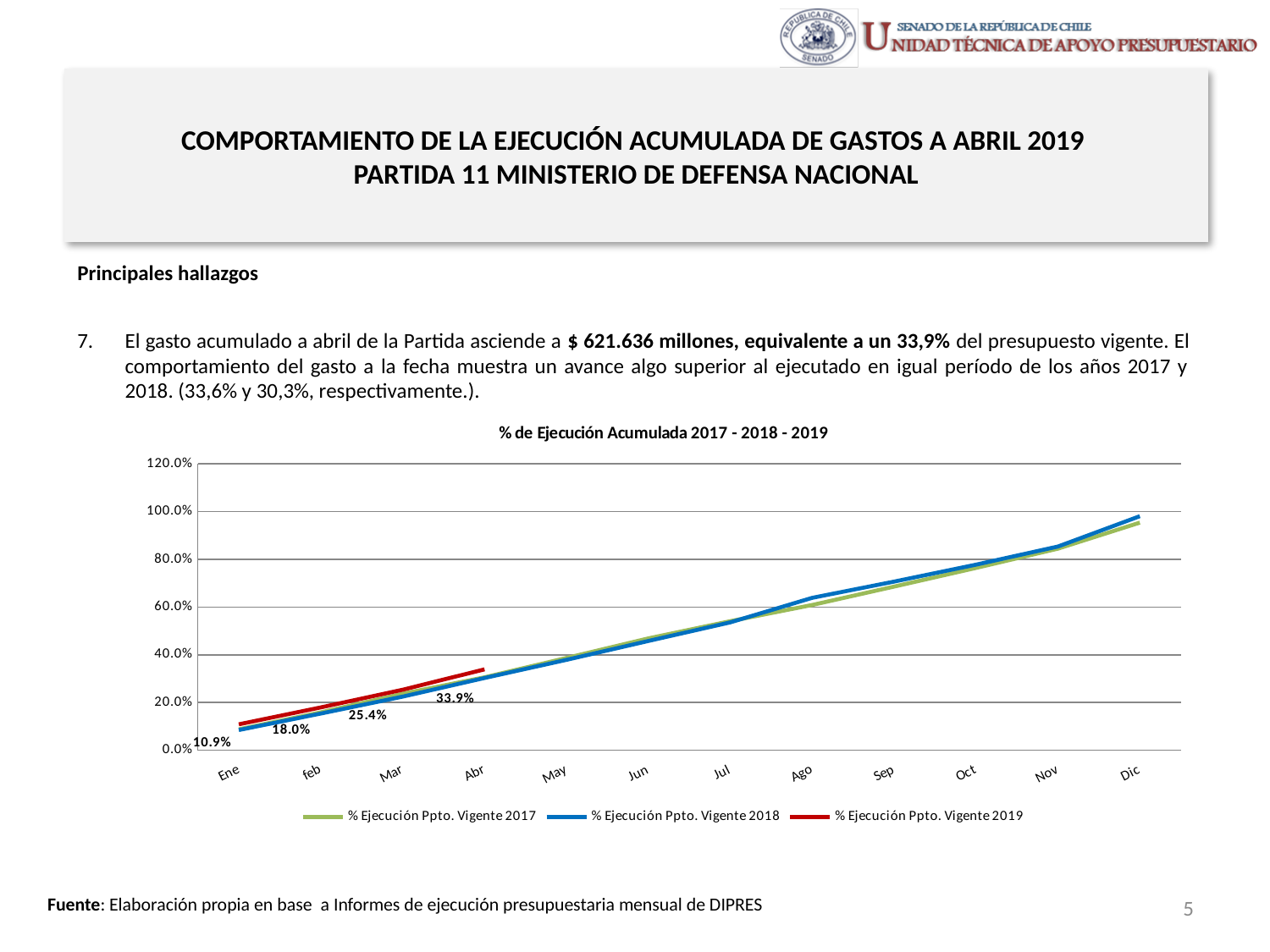
Which month has the highest labelled value for % Ejecución Ppto. Vigente 2019? Abr What is the title of the chart? % de Ejecución Acumulada 2017 - 2018 - 2019 What is the value of % Ejecución Ppto. Vigente 2019 for Abr? 33.9% Is the value for % Ejecución Ppto. Vigente 2018 in Dic greater or less than 80.0%? greater How many months are shown along the x axis of the chart? 12 What is the value of % Ejecución Ppto. Vigente 2019 for Mar? 25.4% Do the values of the series rise or fall from Ene to Dic? rise What is the value of % Ejecución Ppto. Vigente 2019 for Ene? 10.9% What is the value of % Ejecución Ppto. Vigente 2019 for Feb? 18.0% How many series does the chart legend list? 3 What is the difference between the 2019 values for Abr and Mar? 8.5% What kind of chart is shown on the slide? line chart